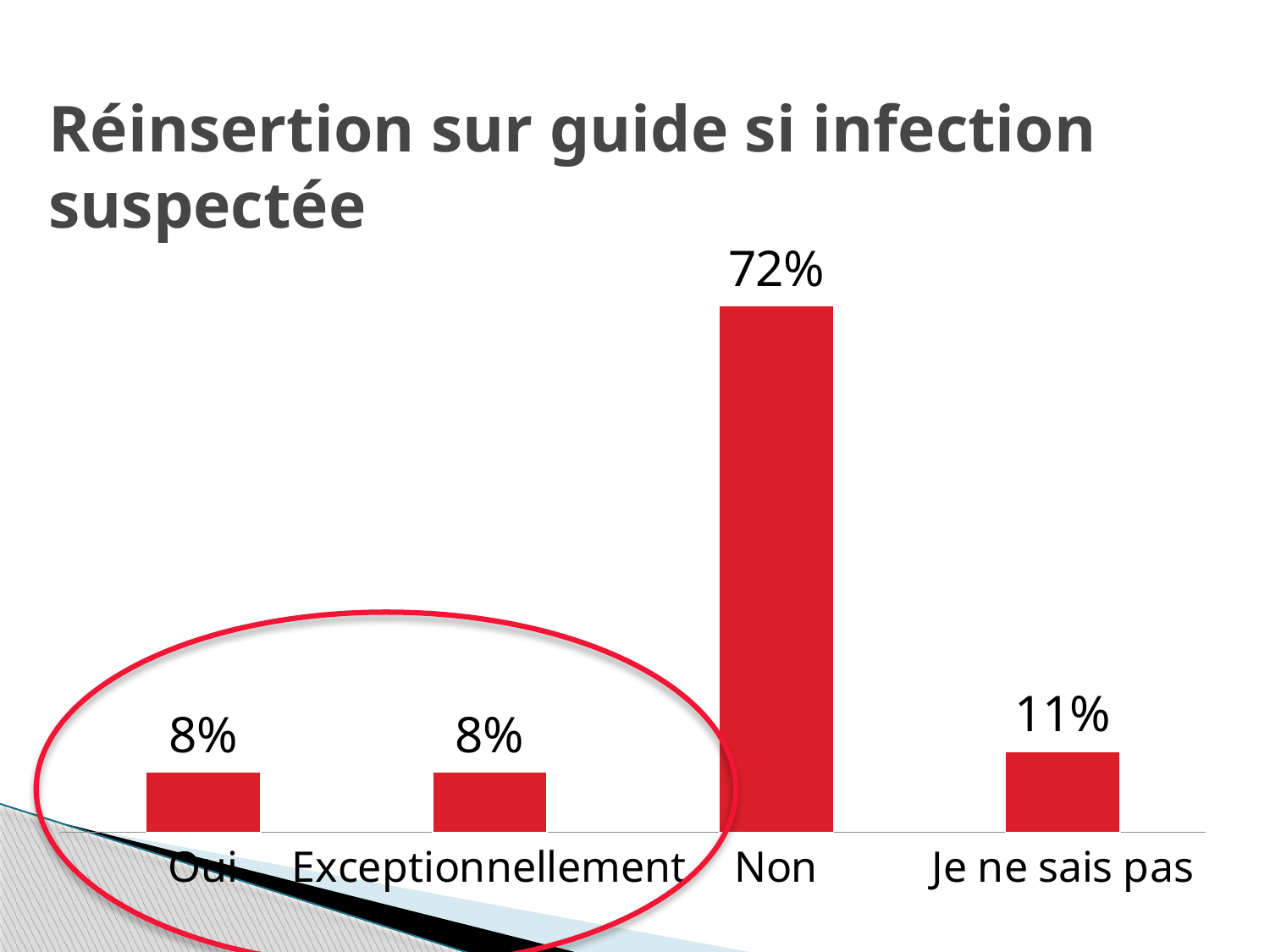
What is the value for Exceptionnellement? 8% What is the value for Je ne sais pas? 11% Which category has the highest value? Non What is the value for Non? 72% How many categories are shown on the x axis? 4 What is the difference between the values for Je ne sais pas and Oui? 3% What is the value for Oui? 8% What kind of chart is shown on the slide? Bar chart Which is larger, the value for Je ne sais pas or the value for Exceptionnellement? Je ne sais pas Which two categories are circled in red on the slide? Oui and Exceptionnellement What is the difference between the values for Non and Je ne sais pas? 61% What is the combined value of Oui and Exceptionnellement? 16%